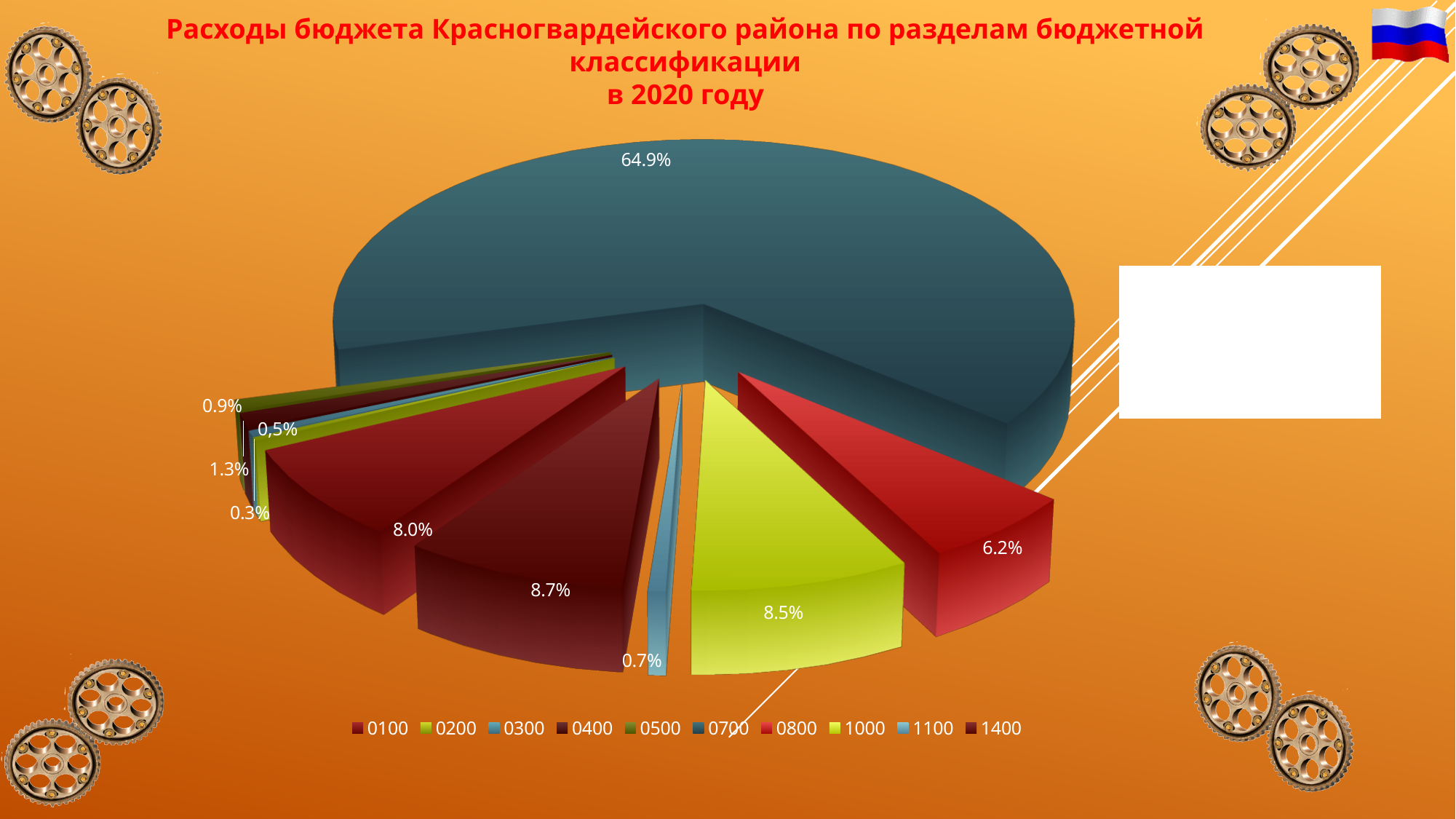
How many categories does the legend of the pie chart list? 10 What share of the pie does category 0700 have? 64.9% What is the smallest percentage labelled on the pie chart? 0.3% What share of the pie does category 1000 have? 8.5% What colour is the slice for category 0700? teal Which year does the chart title say the budget expenditures refer to? 2020 By how many percentage points does the share of category 1000 exceed that of category 0800? 2.3 What kind of chart is shown on the slide? pie chart Which category has the largest share of the pie chart? 0700 Which has the larger share, category 1000 or category 0800? 1000 What share of the pie does category 1100 have? 0.7%